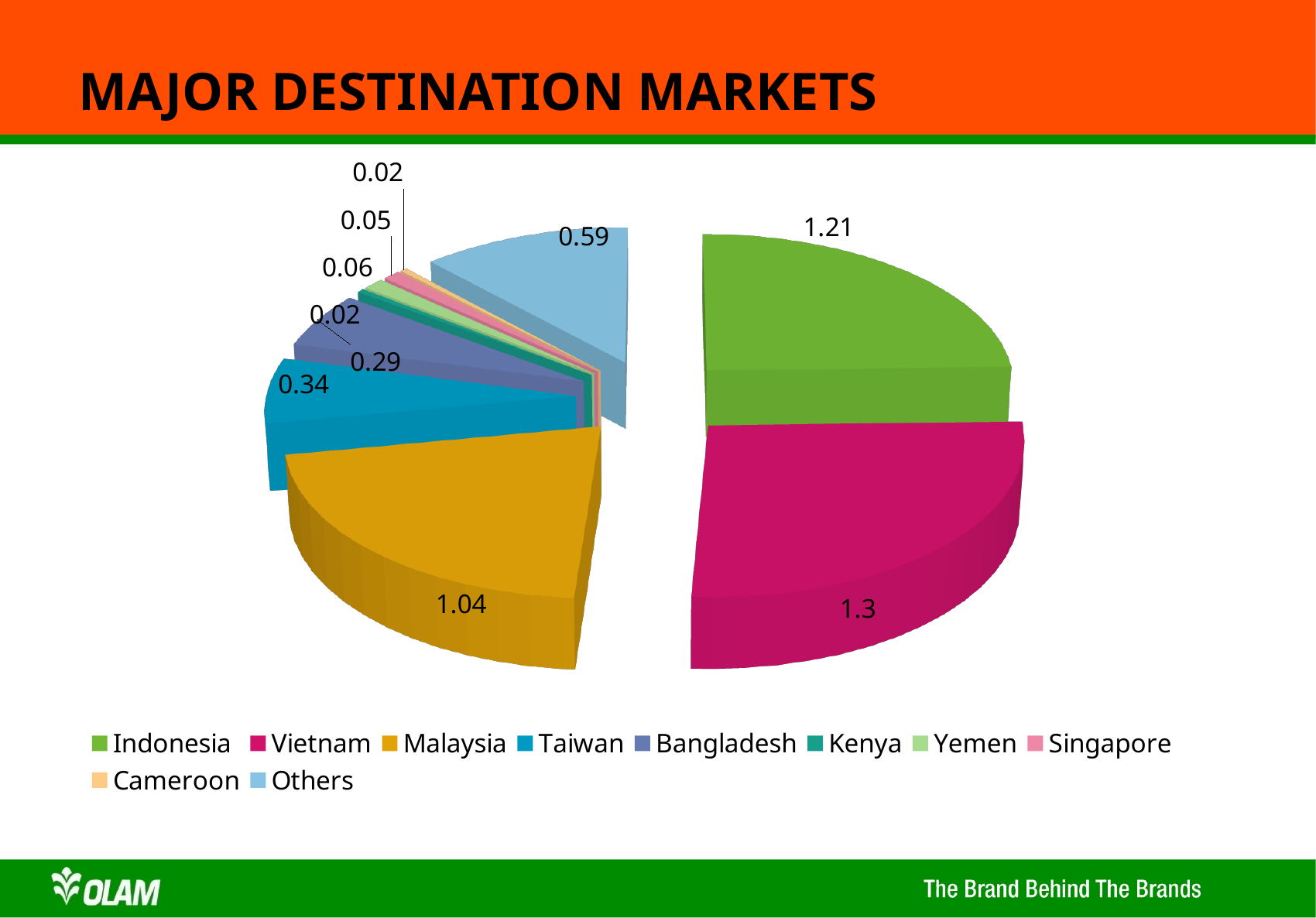
How many destination markets are listed in the legend? 10 What is the value shown for Taiwan? 0.34 What is the value shown for Vietnam? 1.3 What is the difference between the values for Vietnam and Indonesia? 0.09 What is the value shown for Others? 0.59 Which destination market has the largest slice of the pie? Vietnam What is the difference between the values for Malaysia and Others? 0.45 What is the title of the slide? MAJOR DESTINATION MARKETS What is the value shown for Indonesia? 1.21 Which is larger, the value for Taiwan or the value for Bangladesh? Taiwan What kind of chart is shown on the slide? Pie chart What is the value shown for Malaysia? 1.04